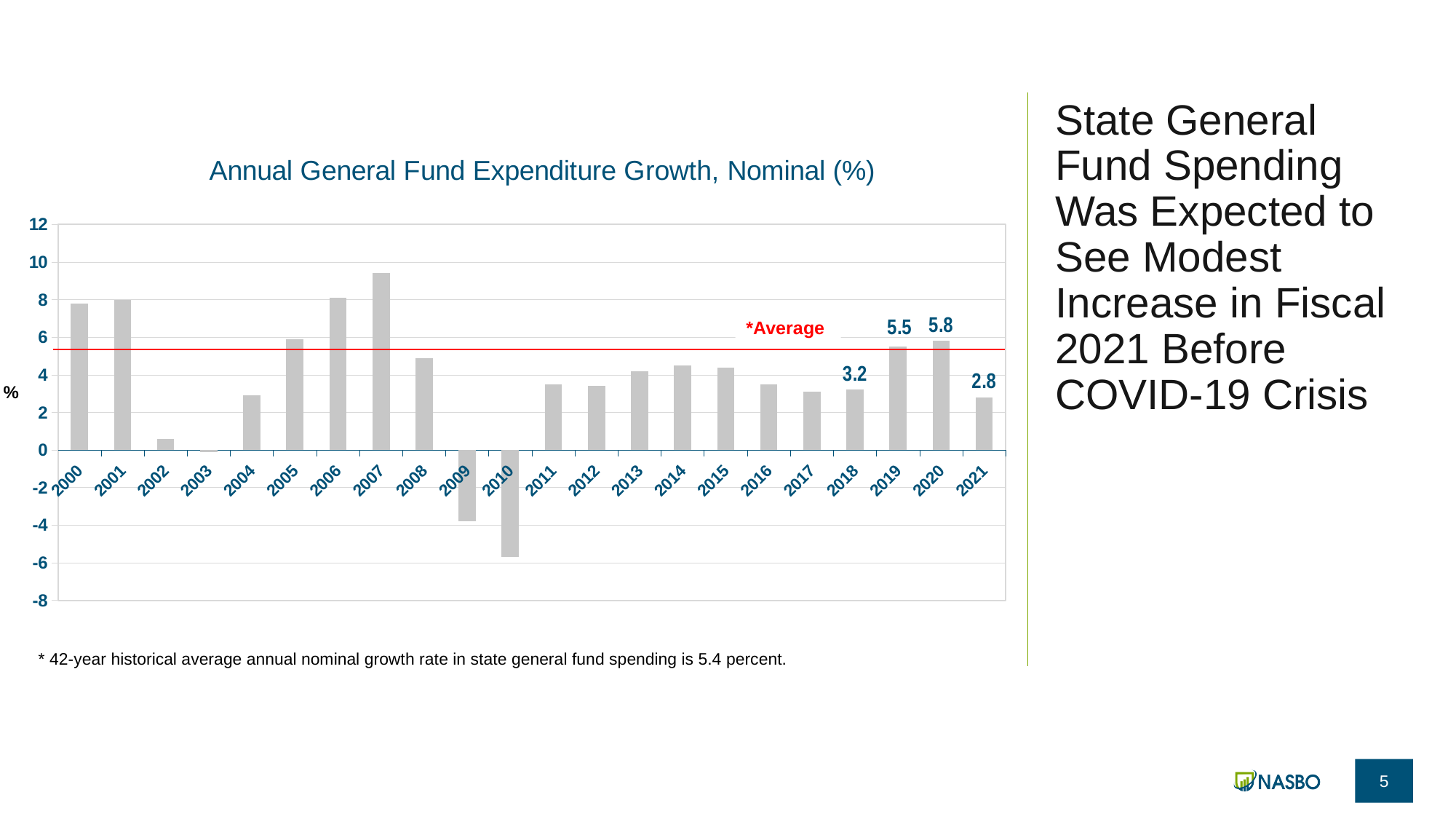
What is the value for 2021 in the Annual General Fund Expenditure Growth chart? 2.8 What is the value for 2019 in the Annual General Fund Expenditure Growth chart? 5.5 Which is larger in the chart, the value for 2019 or the value for 2021? 2019 Which year has the lowest annual general fund expenditure growth in the chart? 2010 Which year has the highest annual general fund expenditure growth in the chart? 2007 What is the difference between the values for 2020 and 2021 in the chart? 3.0 What type of chart is shown on the slide? Bar chart What is the value for 2020 in the Annual General Fund Expenditure Growth chart? 5.8 What is the value for 2018 in the Annual General Fund Expenditure Growth chart? 3.2 Is the value for 2010 in the chart greater or less than -4? less Is the value for 2007 in the chart greater or less than 8? greater How many years are shown on the x axis of the chart? 22